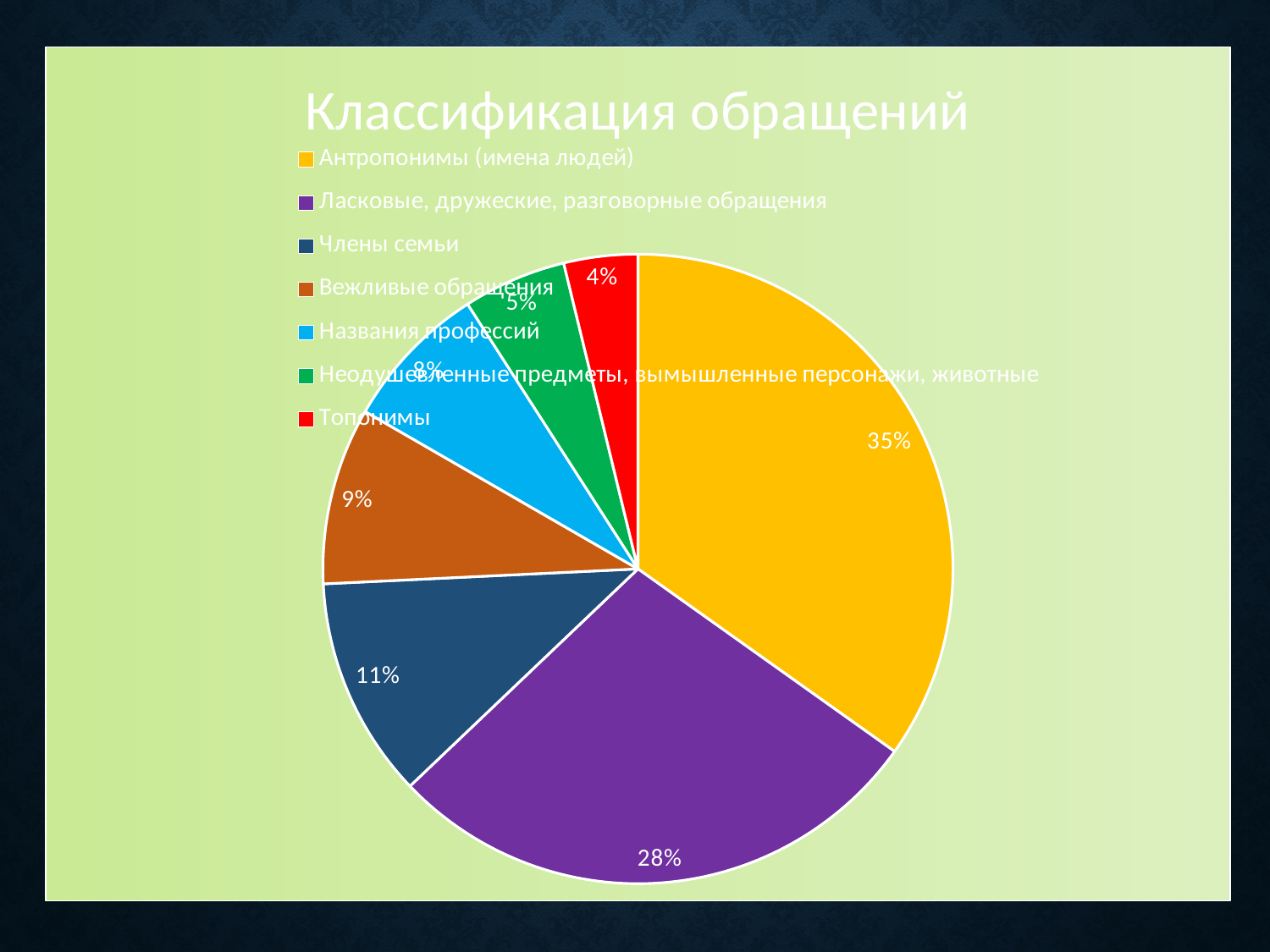
Which is larger: the share for Члены семьи or the share for Вежливые обращения? Члены семьи Which category has the smallest share of the pie? Топонимы What share of the pie is Антропонимы (имена людей)? 35% What share of the pie is Члены семьи? 11% What share of the pie is Топонимы? 4% What share of the pie is Ласковые, дружеские, разговорные обращения? 28% What kind of chart is shown on the slide? pie chart Which category has the largest share of the pie? Антропонимы (имена людей) What share of the pie is Вежливые обращения? 9% What is the title of the chart? Классификация обращений How many categories does the pie chart have? 7 What is the difference in percentage points between Антропонимы (имена людей) and Ласковые, дружеские, разговорные обращения? 7